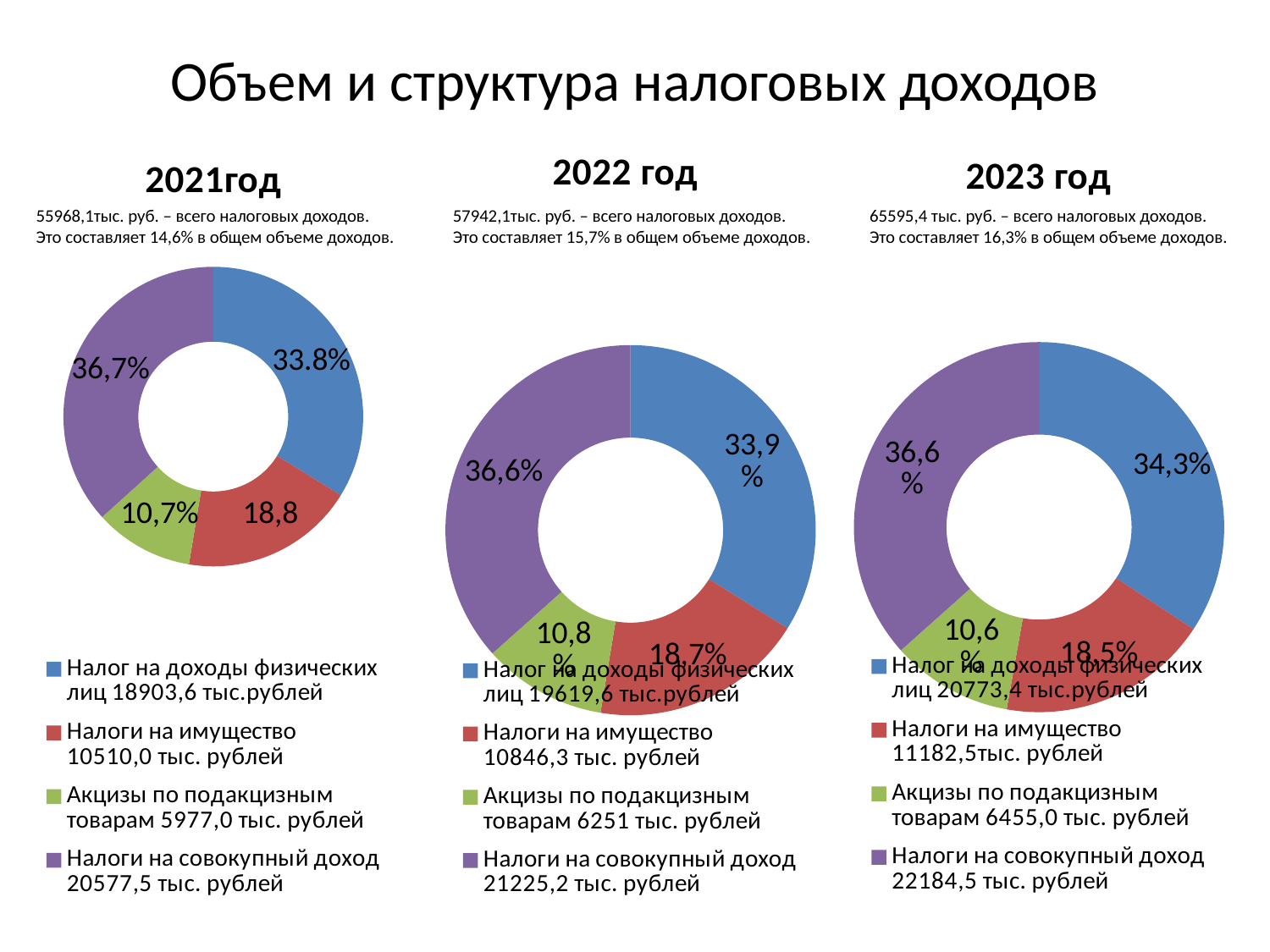
What kind of chart is used for the 2021 год data? Doughnut chart In the 2023 год chart, what share is shown for Акцизы по подакцизным товарам? 10,6% In the 2021 год chart, what share is shown for Налог на доходы физических лиц? 33.8% In the 2022 год chart, which category has the smallest slice? Акцизы по подакцизным товарам How many entries does the legend of the 2023 год chart list? 4 In the 2023 год chart, what share is shown for Налоги на имущество? 18,5% In the 2023 год chart, which is larger: Налог на доходы физических лиц or Налоги на имущество? Налог на доходы физических лиц How many categories are shown in the 2021 год chart? 4 In the 2022 год chart, what is the difference between the shares of Налог на доходы физических лиц and Налоги на имущество? 15,2% In the 2023 год chart, which category has the largest slice? Налоги на совокупный доход In the 2022 год chart, what share is shown for Налоги на совокупный доход? 36,6% In the legend of the 2023 год chart, what amount is given for Налоги на совокупный доход? 22184,5 тыс. рублей